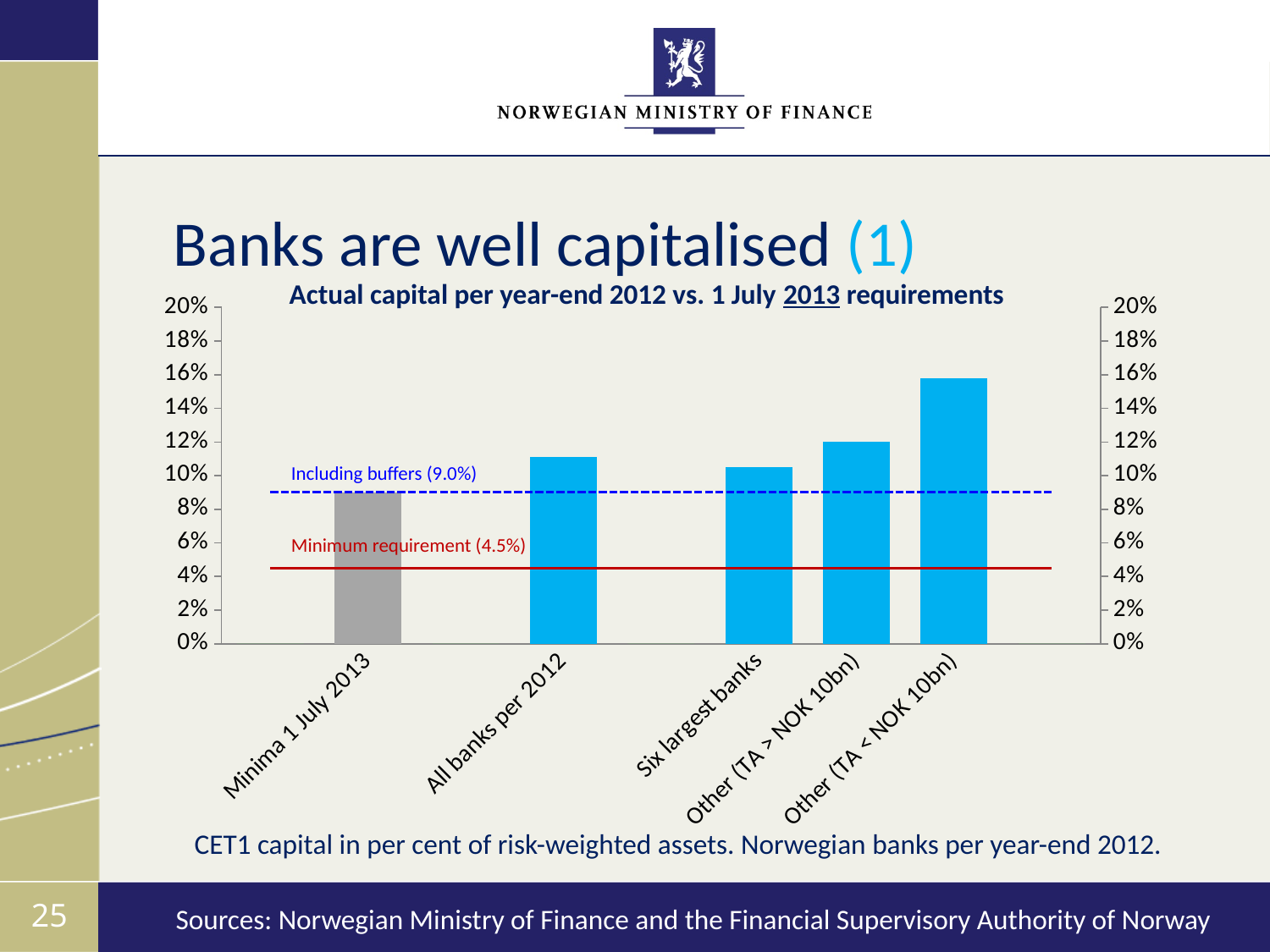
What is the title of the chart? Actual capital per year-end 2012 vs. 1 July 2013 requirements Which category has the lowest bar in the chart? Minima 1 July 2013 What level is the 'Minimum requirement' line drawn at? 4.5% How many categories are shown on the x axis of the chart? 5 What level is the 'Including buffers' line drawn at? 9.0% Which category has the highest bar in the chart? Other (TA < NOK 10bn) Is the value for Six largest banks greater or less than 12%? less Which is larger, the bar for Other (TA > NOK 10bn) or the bar for Six largest banks? Other (TA > NOK 10bn) What kind of chart is shown on the slide? bar chart What is the difference between the 'Including buffers' level and the 'Minimum requirement' level? 4.5 percentage points Is the value for Other (TA < NOK 10bn) greater or less than 14%? greater Is the value for All banks per 2012 greater or less than 10%? greater